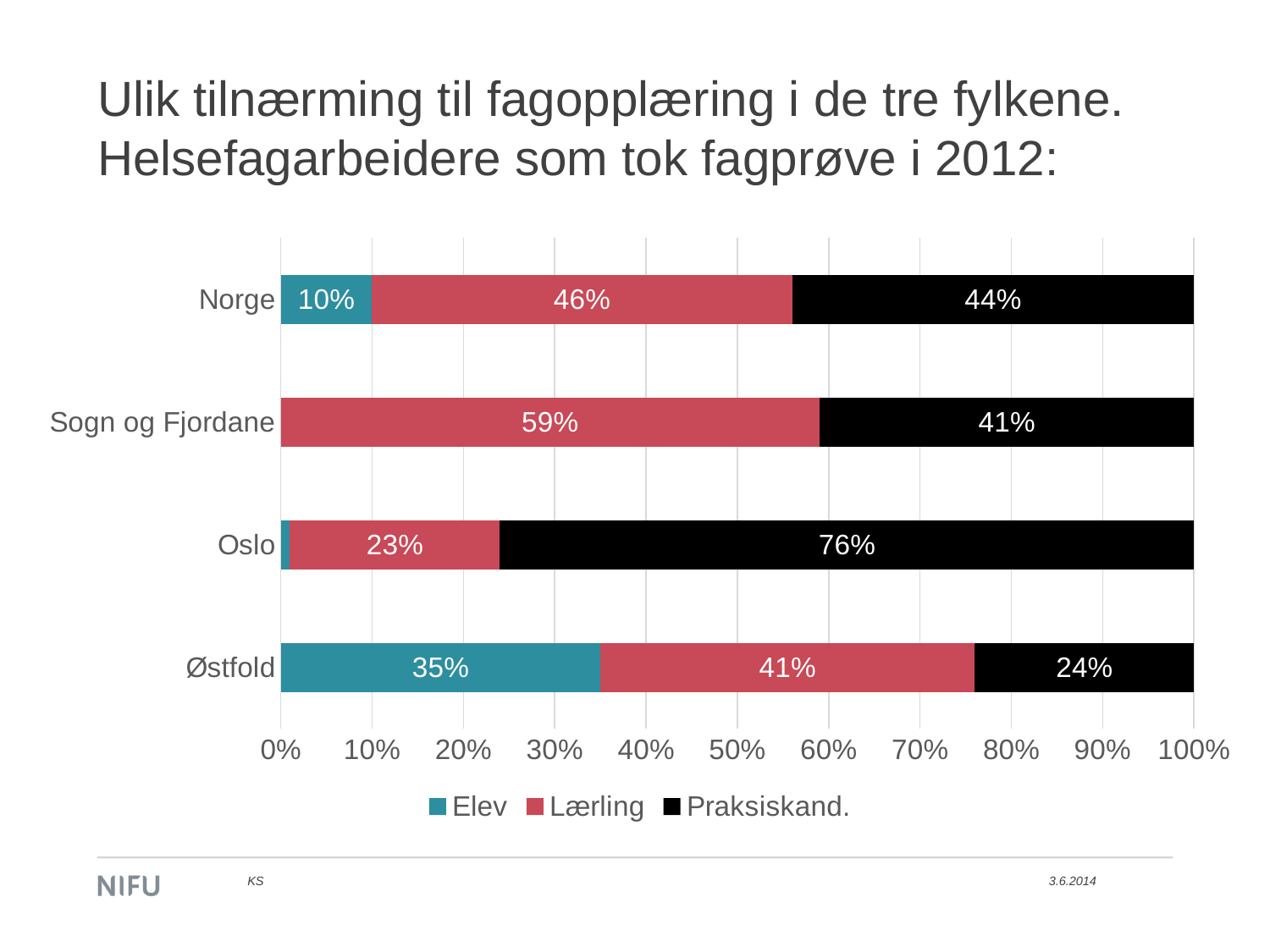
Is the Elev value for Oslo greater or less than 10%? less Which category has the highest Praksiskand. value? Oslo What kind of chart is shown on the slide? Stacked bar chart Which category has the lowest Praksiskand. value? Østfold What is the Elev value for Østfold? 35% What is the difference between the Lærling and Praksiskand. values for Østfold? 17 percentage points What is the Lærling value for Norge? 46% How many categories are shown on the y axis? 4 Which is larger for Norge, the Lærling value or the Praksiskand. value? Lærling How many series does the legend list? 3 What is the Praksiskand. value for Oslo? 76% What is the Lærling value for Sogn og Fjordane? 59%